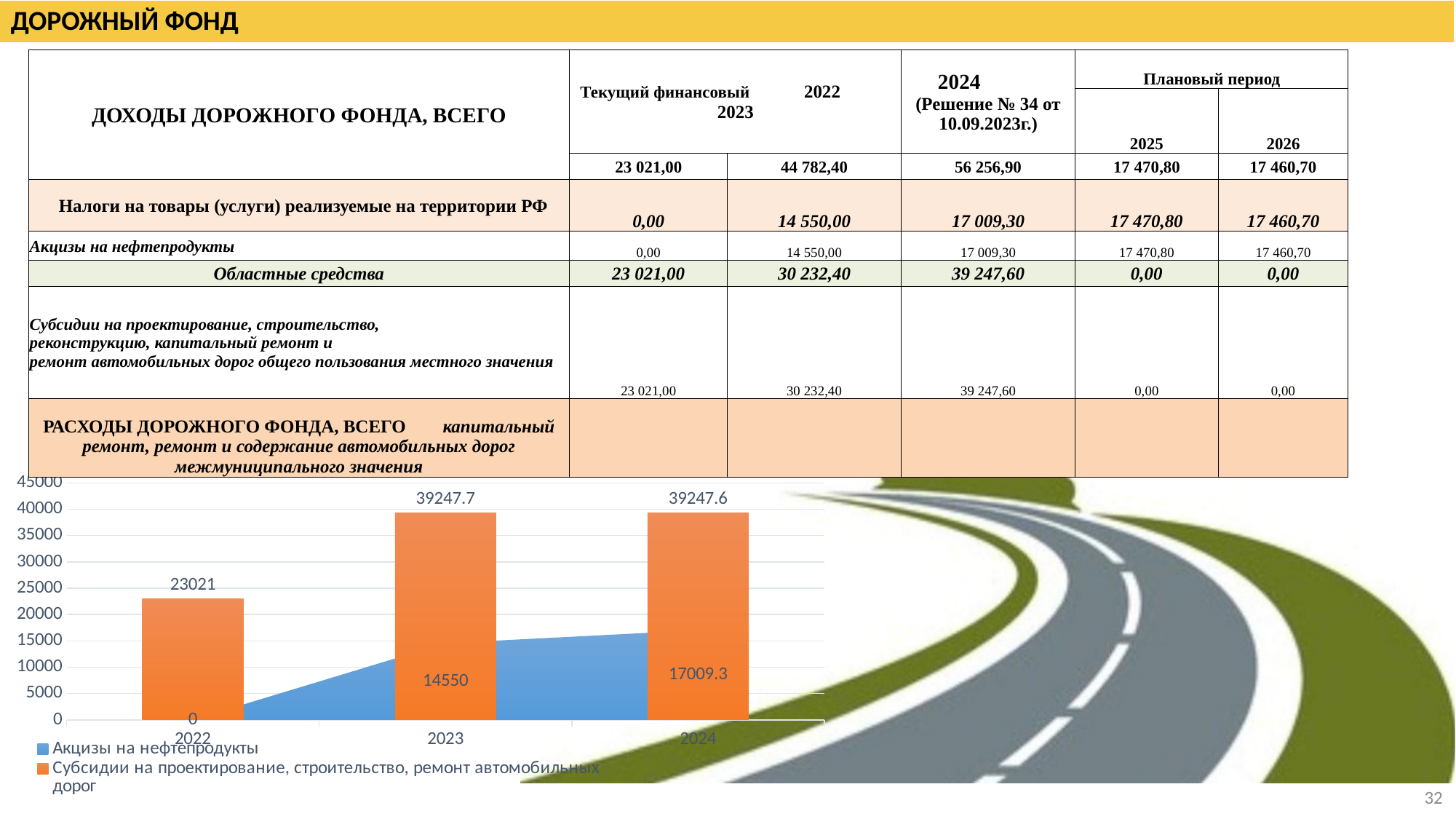
In the chart, what is the value of Субсидии на проектирование, строительство, ремонт автомобильных дорог for 2023? 39247.7 How many series does the chart legend list? 2 In the chart, what is the value of Субсидии на проектирование, строительство, ремонт автомобильных дорог for 2022? 23021 In the chart, what is the value of Акцизы на нефтепродукты for 2024? 17009.3 In the chart, which year has the lowest value for Акцизы на нефтепродукты? 2022 In the chart, which series has the larger value in 2024: Акцизы на нефтепродукты or Субсидии на проектирование, строительство, ремонт автомобильных дорог? Субсидии на проектирование, строительство, ремонт автомобильных дорог How many years are shown on the x axis of the chart? 3 In the chart, what is the value of Акцизы на нефтепродукты for 2022? 0 In the chart, do the values for Акцизы на нефтепродукты rise or fall from 2022 to 2024? rise In the chart, by how much does Субсидии на проектирование, строительство, ремонт автомобильных дорог in 2023 exceed its 2022 value? 16226.7 In the chart, what is the value of Акцизы на нефтепродукты for 2023? 14550 In the chart, which year has the lowest value for Субсидии на проектирование, строительство, ремонт автомобильных дорог? 2022